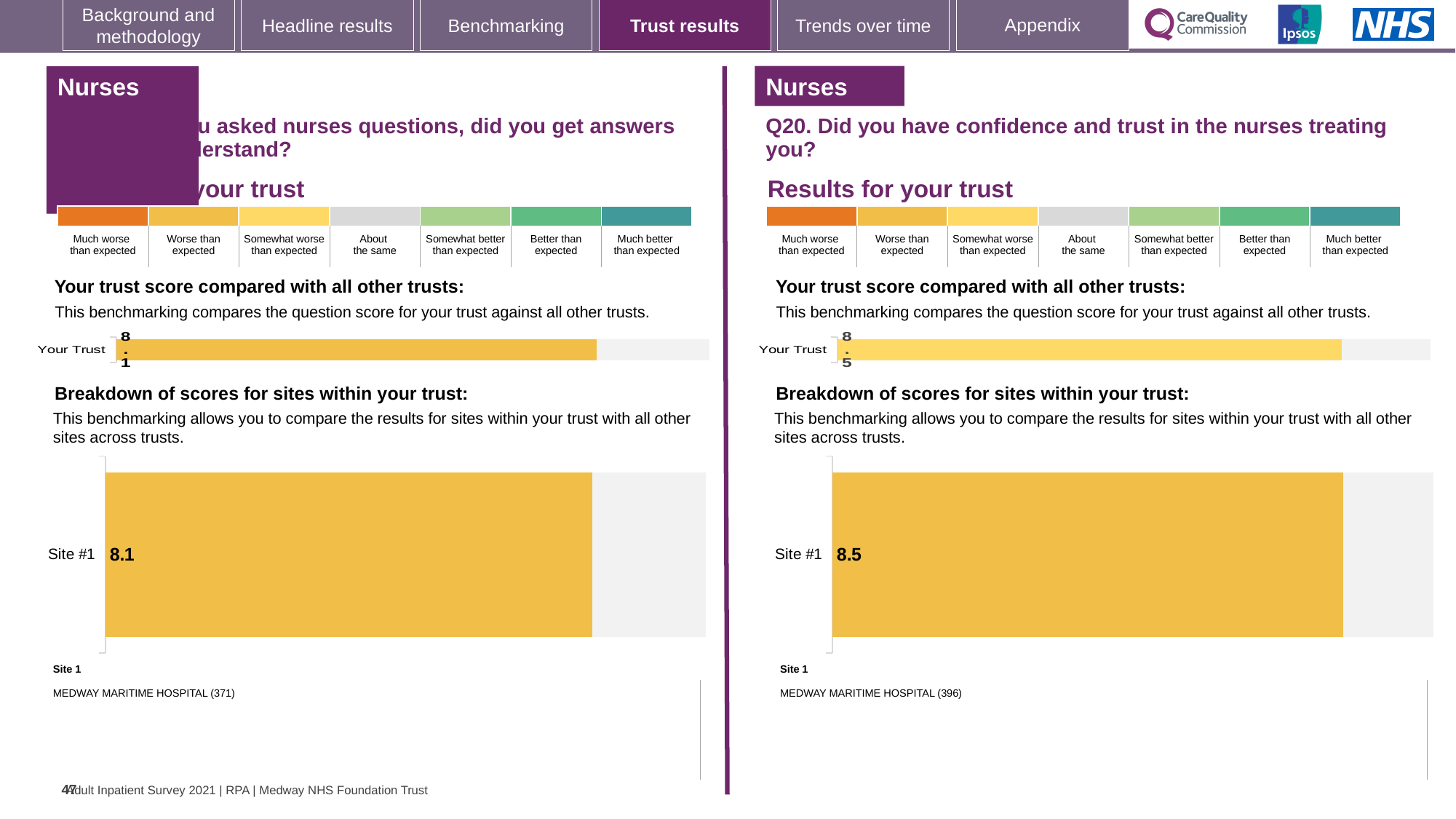
Which Site #1 score is larger: the one on the left half of the slide or the one on the right half (Q20)? Right half (Q20) On the left half of the slide, what is the score shown for Site #1? 8.1 What is the difference between the Site #1 score on the right half (Q20) and the Site #1 score on the left half of the slide? 0.4 How many sites are shown in the site breakdown chart on the right half of the slide (Q20)? 1 On the right half of the slide (Q20), what is the score shown for Your Trust in the trust comparison bar? 8.5 What kind of chart is used to show the Site #1 score on each half of the slide? Bar chart Is the Site #1 score on the left half of the slide greater or less than the Your Trust score on the right half (Q20)? less How many sites are shown in the site breakdown chart on the left half of the slide? 1 On the right half of the slide (Q20), what is the score shown for Site #1? 8.5 Which site name is listed as Site 1 on the right half of the slide (Q20)? MEDWAY MARITIME HOSPITAL (396) On the left half of the slide, what is the score shown for Your Trust in the trust comparison bar? 8.1 What colour is the Site #1 bar on the right half of the slide (Q20)? Yellow